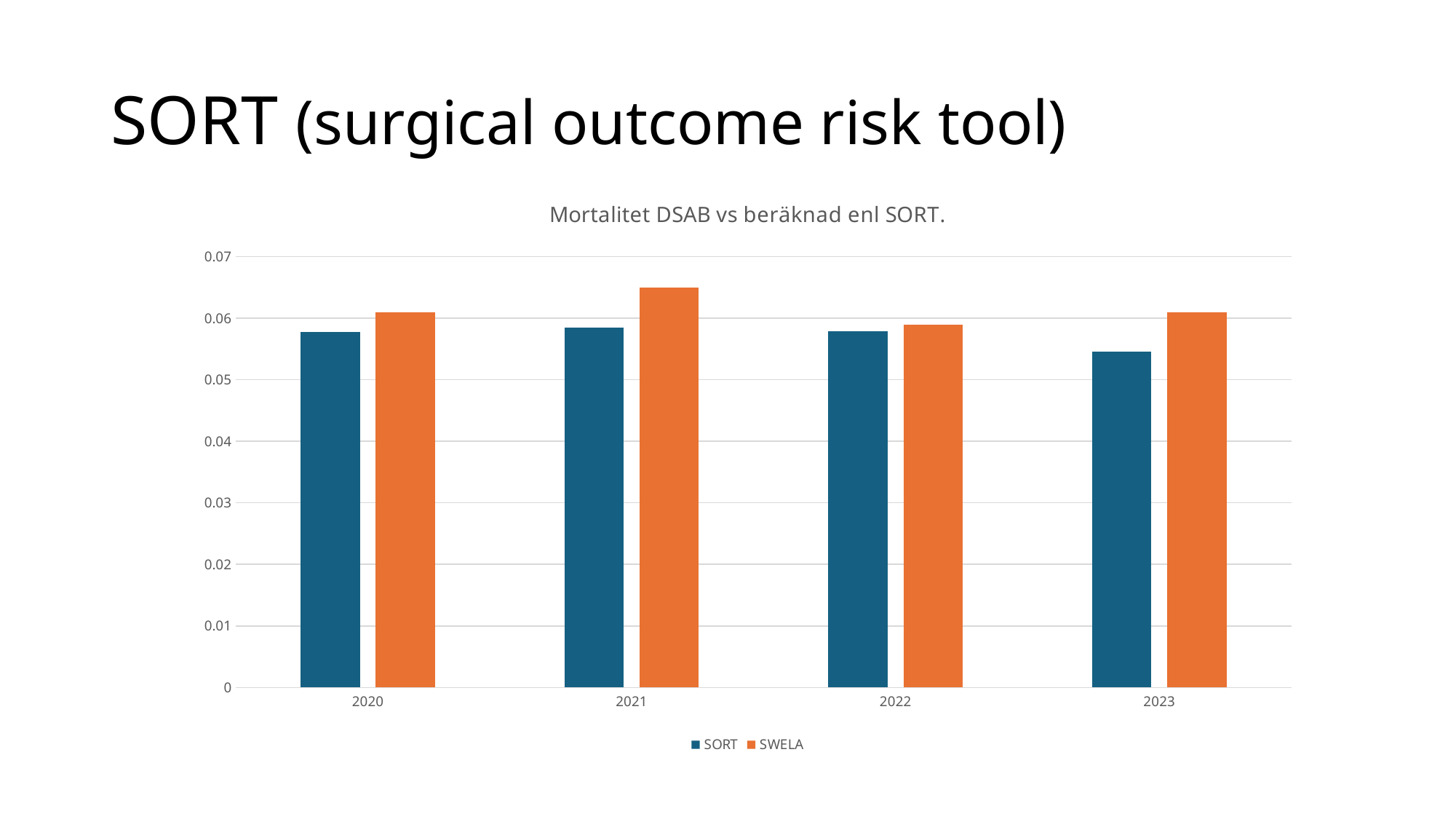
Is the SORT value for 2023 greater or less than 0.06? less How many years are shown on the x axis? 4 What kind of chart is shown on the slide? bar chart In 2021, which is larger, SORT or SWELA? SWELA Is the SWELA value for 2021 greater or less than 0.06? greater In 2023, which is larger, SORT or SWELA? SWELA Is the SORT value for 2020 greater or less than 0.05? greater In which year is the SORT value lowest? 2023 In which year is the SWELA value highest? 2021 Which series is shown in orange? SWELA How many series does the legend list? 2 What is the title of the chart? Mortalitet DSAB vs beräknad enl SORT.